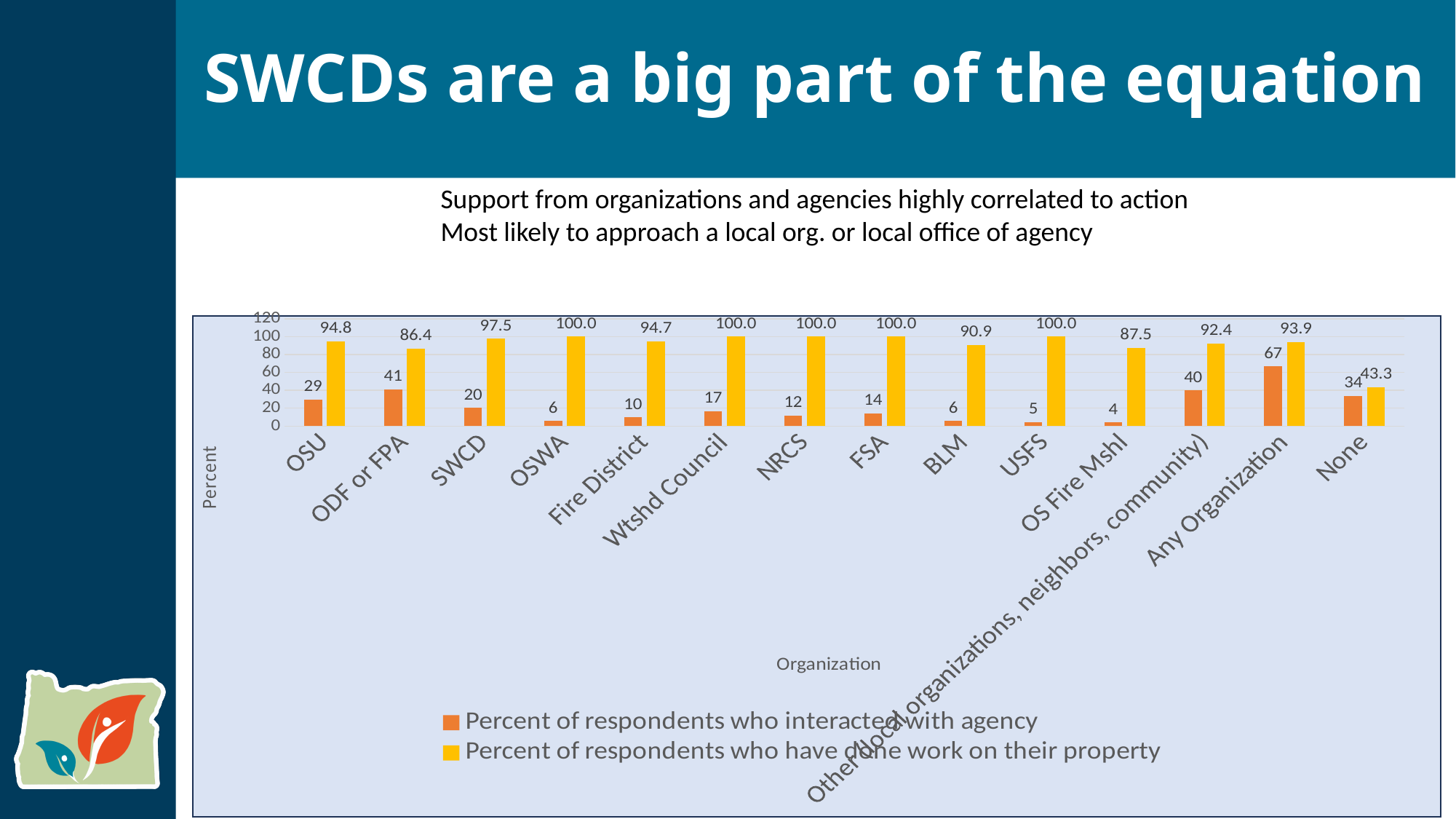
Which organization has the lowest percent of respondents who interacted with agency? OS Fire Mshl Which category has the lowest percent of respondents who have done work on their property? None Which is larger: the percent of respondents who interacted with agency for NRCS or for FSA? FSA What is the label of the y axis? Percent What is the percent of respondents who interacted with agency for SWCD? 20 How many organization categories are shown on the x axis? 14 What is the percent of respondents who have done work on their property for SWCD? 97.5 What type of chart is shown on the slide? bar chart What is the difference between the percent of respondents who have done work on their property for OSU and for ODF or FPA? 8.4 How many series does the legend list? 2 What is the percent of respondents who interacted with agency for ODF or FPA? 41 Which organization has the highest percent of respondents who interacted with agency? Any Organization